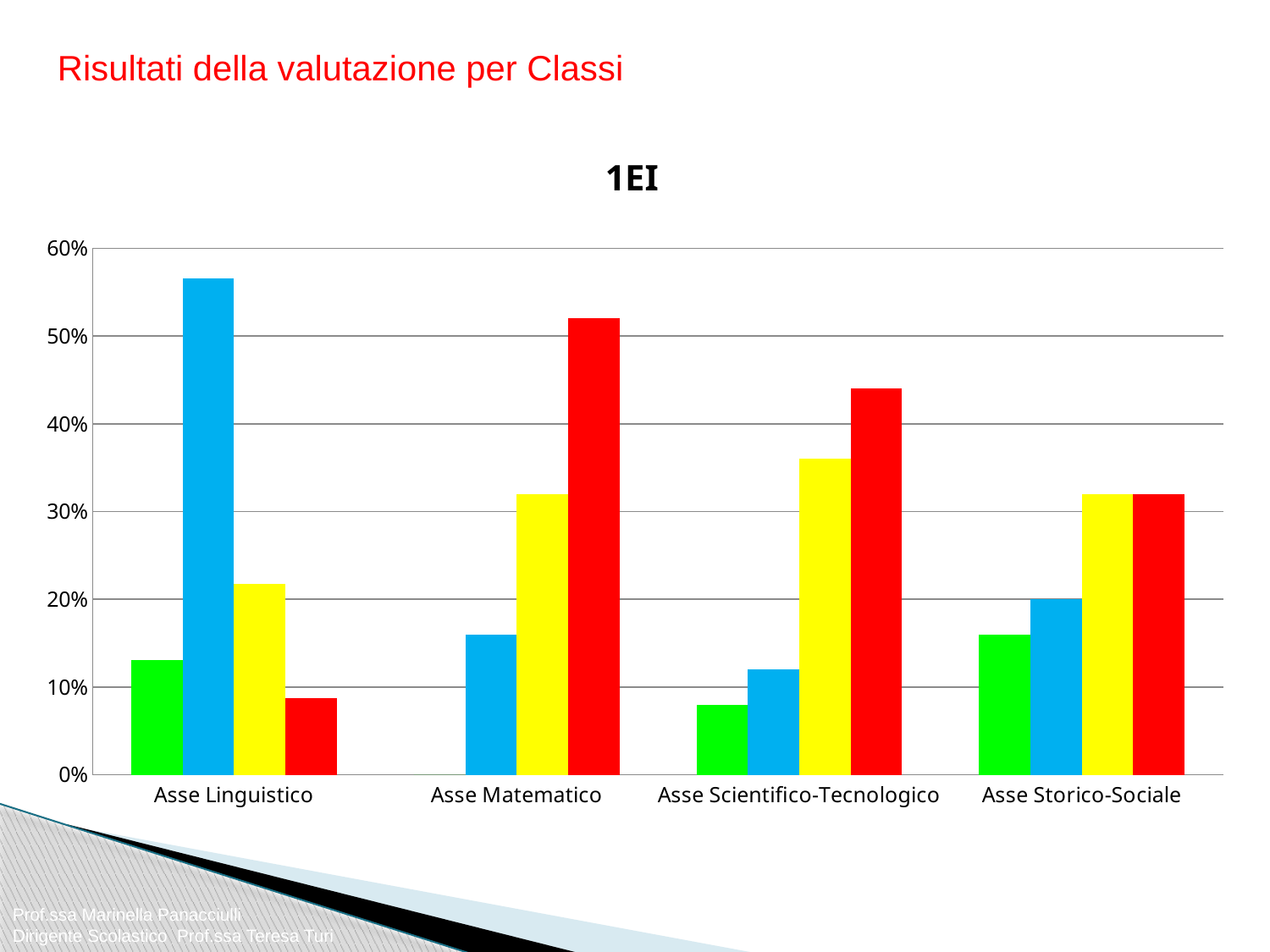
How many categories are shown on the x axis of the chart? 4 Is the value of the blue bar for Asse Storico-Sociale greater or less than 30%? less Is the value of the red bar for Asse Matematico greater or less than 40%? greater Which coloured bar is the shortest in the Asse Linguistico category? red Is the value of the red bar for Asse Scientifico-Tecnologico greater or less than 40%? greater Which category contains the tallest bar in the chart? Asse Linguistico In the Asse Matematico category, which is larger: the red bar or the yellow bar? red In the Asse Scientifico-Tecnologico category, which is larger: the green bar or the yellow bar? yellow What is the title of the chart? 1EI What kind of chart is shown on the slide? bar chart